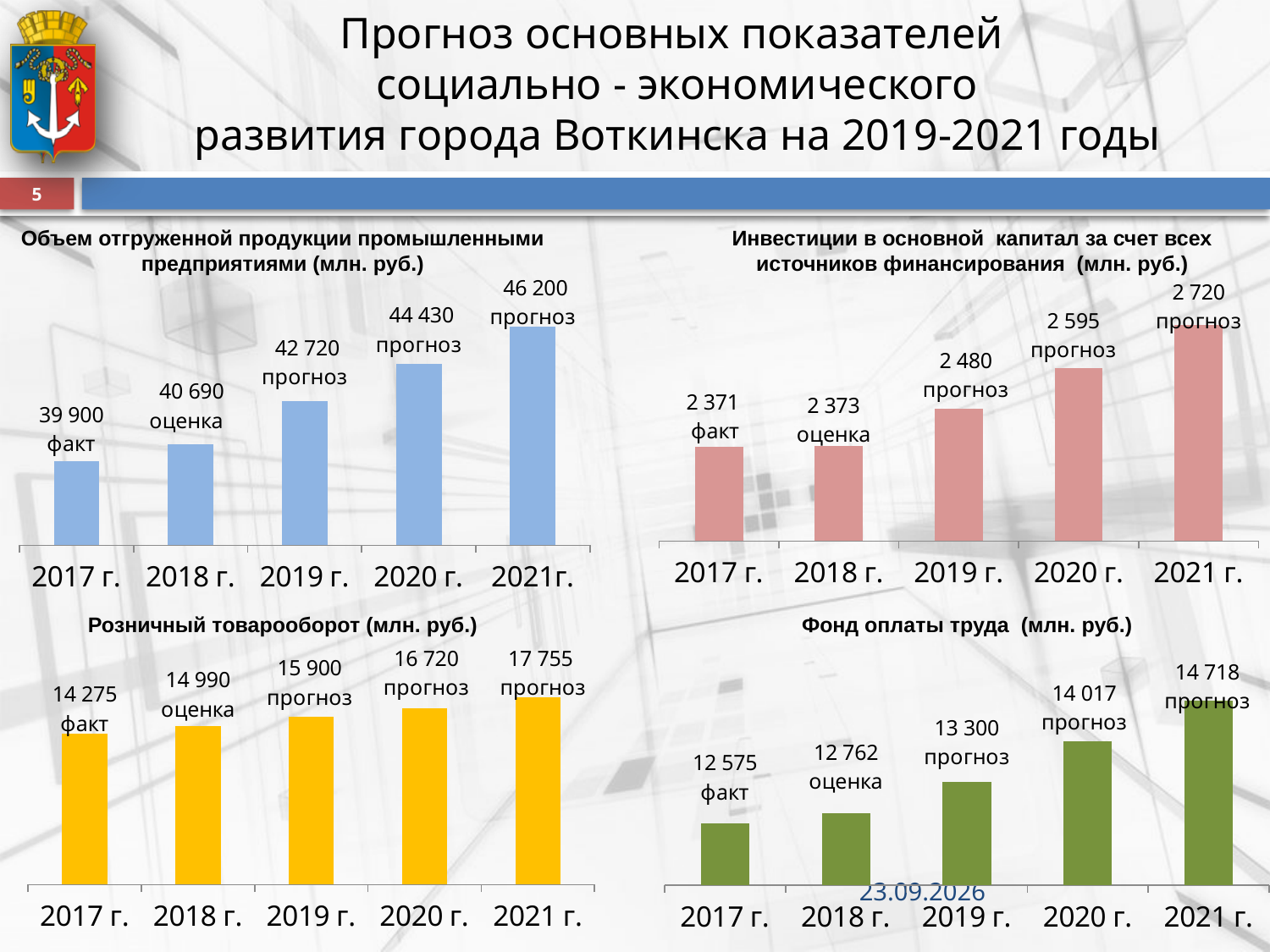
In the chart 'Объем отгруженной продукции промышленными предприятиями (млн. руб.)', which year has the highest value? 2021г. What kind of chart is 'Фонд оплаты труда (млн. руб.)'? bar chart In the chart 'Розничный товарооборот (млн. руб.)', what is the value for 2018 г.? 14 990 In the chart 'Инвестиции в основной капитал за счет всех источников финансирования (млн. руб.)', what is the value for 2020 г.? 2 595 In the chart 'Объем отгруженной продукции промышленными предприятиями (млн. руб.)', what is the difference between the 2021 and 2017 values? 6 300 In the chart 'Розничный товарооборот (млн. руб.)', do the values rise or fall from 2017 to 2021? rise In the chart 'Инвестиции в основной капитал за счет всех источников финансирования (млн. руб.)', how many years are plotted? 5 In the chart 'Розничный товарооборот (млн. руб.)', what is the difference between the 2020 and 2019 values? 820 In the chart 'Инвестиции в основной капитал за счет всех источников финансирования (млн. руб.)', which year has the lowest value? 2017 г. In the chart 'Фонд оплаты труда (млн. руб.)', which is larger, the value for 2019 г. or 2020 г.? 2020 г. In the chart 'Объем отгруженной продукции промышленными предприятиями (млн. руб.)', what is the value for 2019 г.? 42 720 In the chart 'Фонд оплаты труда (млн. руб.)', what is the value for 2021 г.? 14 718